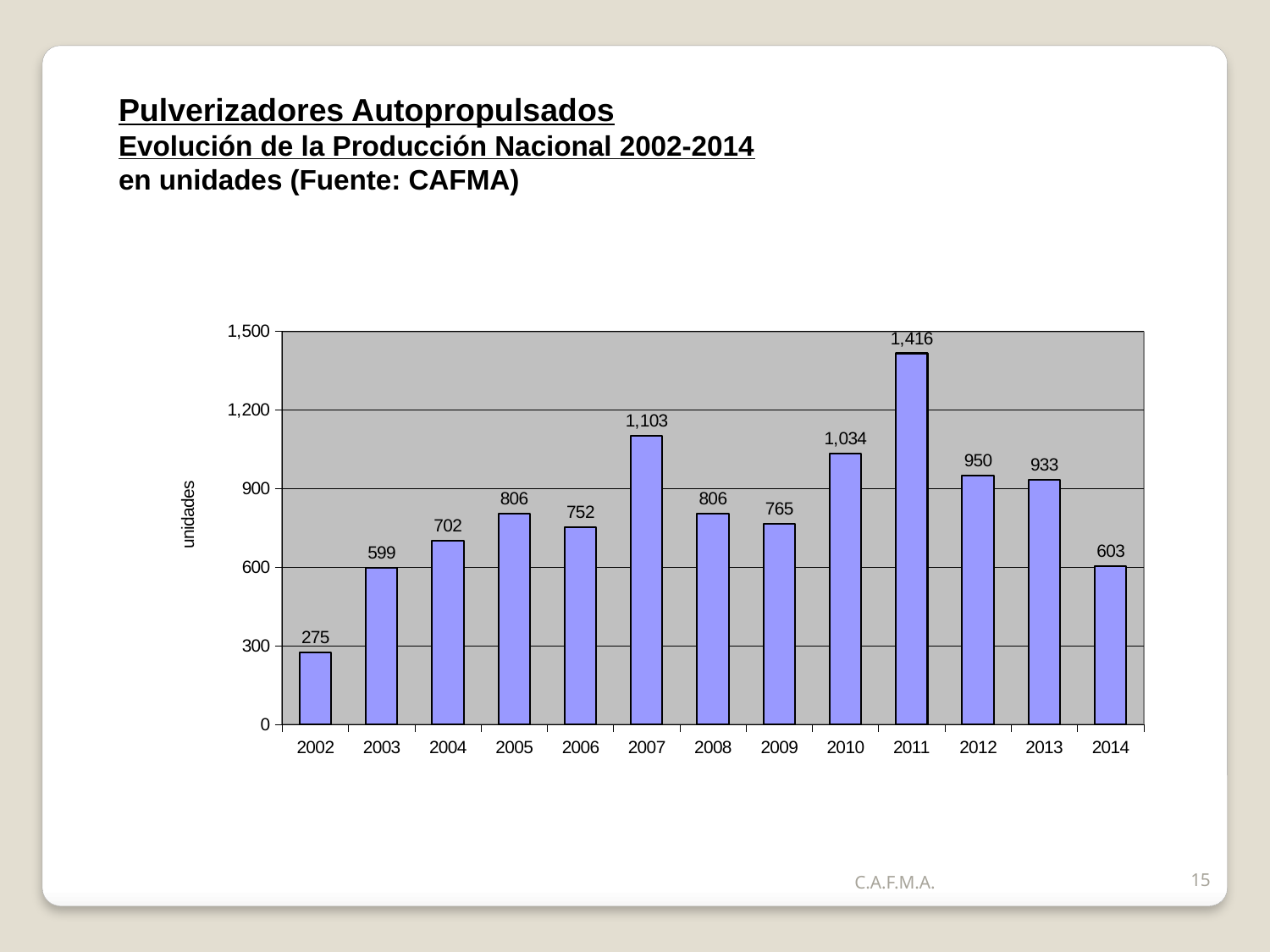
What is the production value for 2002? 275 Is the value for 2012 greater or less than 900? greater What is the label on the vertical axis? unidades What is the difference between the production in 2013 and 2014? 330 Which year has the highest production? 2011 What is the difference between the production in 2011 and 2010? 382 Which year has the lowest production? 2002 What is the production value for 2011? 1,416 What is the production value for 2014? 603 Which year has a larger production value, 2007 or 2010? 2007 What kind of chart is shown on the slide? Bar chart How many years are shown on the x axis? 13